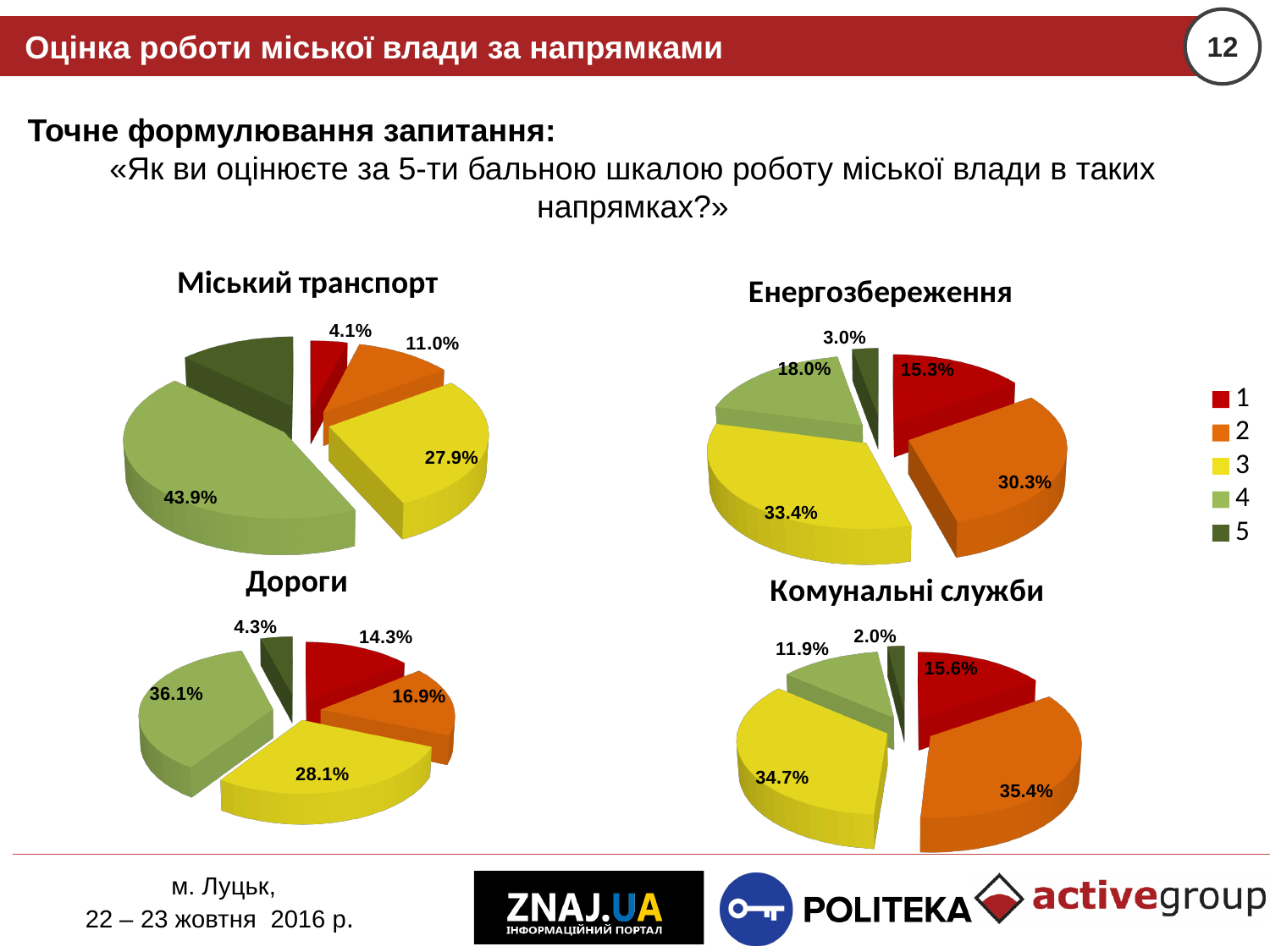
In the 'Енергозбереження' pie chart, what share is shown for rating 2? 30.3% In the 'Комунальні служби' pie chart, what share is shown for rating 5? 2.0% In the 'Міський транспорт' pie chart, what share is shown for rating 1? 4.1% In the 'Енергозбереження' pie chart, which rating has the largest share? 3 In the 'Дороги' pie chart, what share is shown for rating 3? 28.1% In the 'Енергозбереження' pie chart, which rating has the smallest share? 5 In the 'Дороги' pie chart, what is the difference between the shares for rating 4 and rating 1? 21.8% How many series does the legend list? 5 In the 'Комунальні служби' pie chart, which is larger: the share for rating 1 or the share for rating 4? rating 1 What type of chart is used for 'Комунальні служби'? pie chart In the 'Дороги' pie chart, which rating has the largest share? 4 In the 'Міський транспорт' pie chart, what share is shown for rating 4? 43.9%